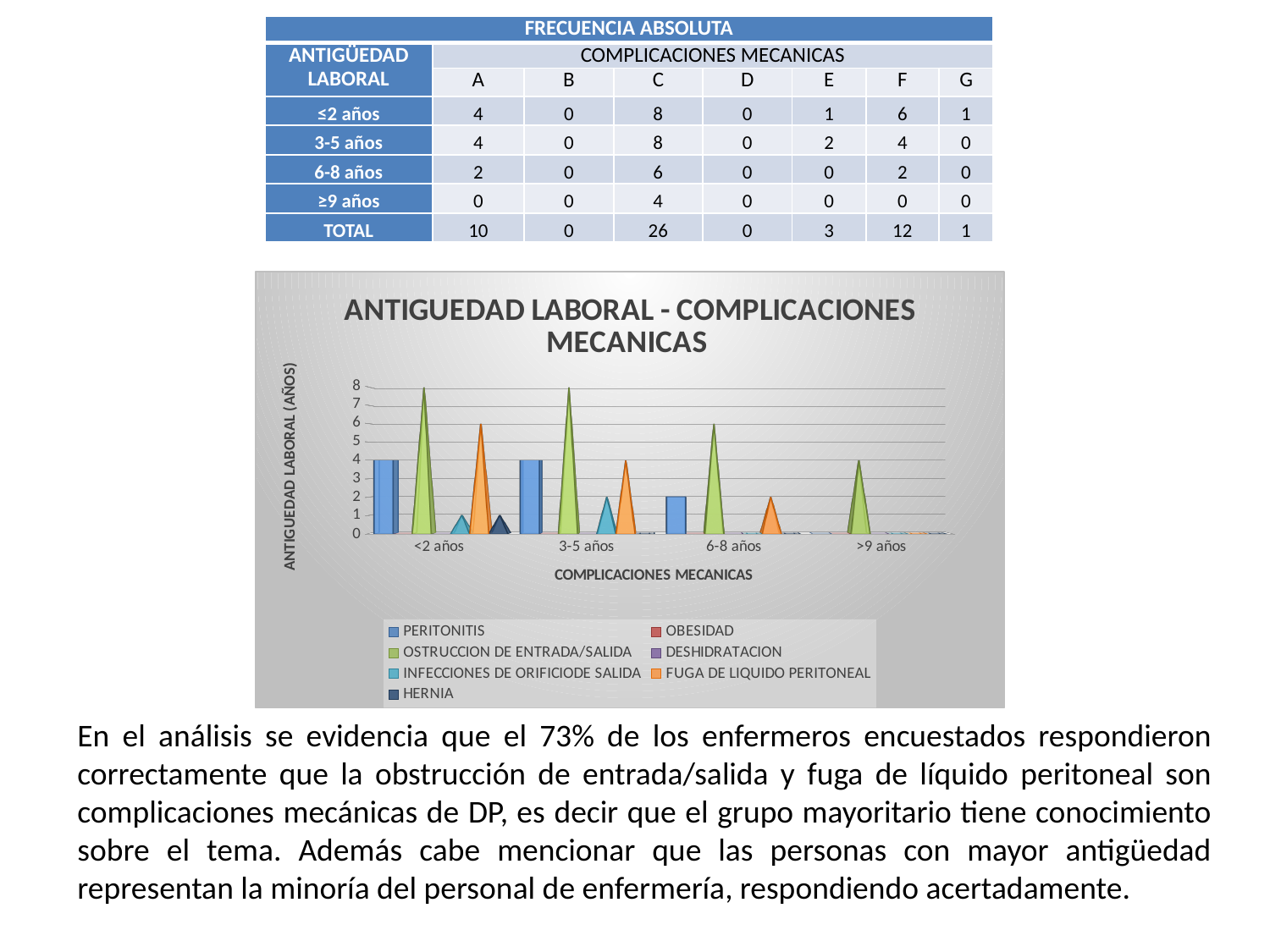
What is the difference between OSTRUCCION DE ENTRADA/SALIDA and PERITONITIS in the <2 años category? 4 Is the value for OSTRUCCION DE ENTRADA/SALIDA in the 6-8 años category greater or less than 4? greater Which category has the lowest value for PERITONITIS? >9 años What is the value for FUGA DE LIQUIDO PERITONEAL in the 3-5 años category? 4 What kind of chart is shown on the slide? bar chart What is the value for PERITONITIS in the 6-8 años category? 2 What is the value for OSTRUCCION DE ENTRADA/SALIDA in the <2 años category? 8 What is the title of the chart? ANTIGUEDAD LABORAL - COMPLICACIONES MECANICAS Which category has the highest value for FUGA DE LIQUIDO PERITONEAL? <2 años How many series does the chart legend list? 7 In the 3-5 años category, which is larger: PERITONITIS or OSTRUCCION DE ENTRADA/SALIDA? OSTRUCCION DE ENTRADA/SALIDA How many categories are shown along the x axis of the chart? 4